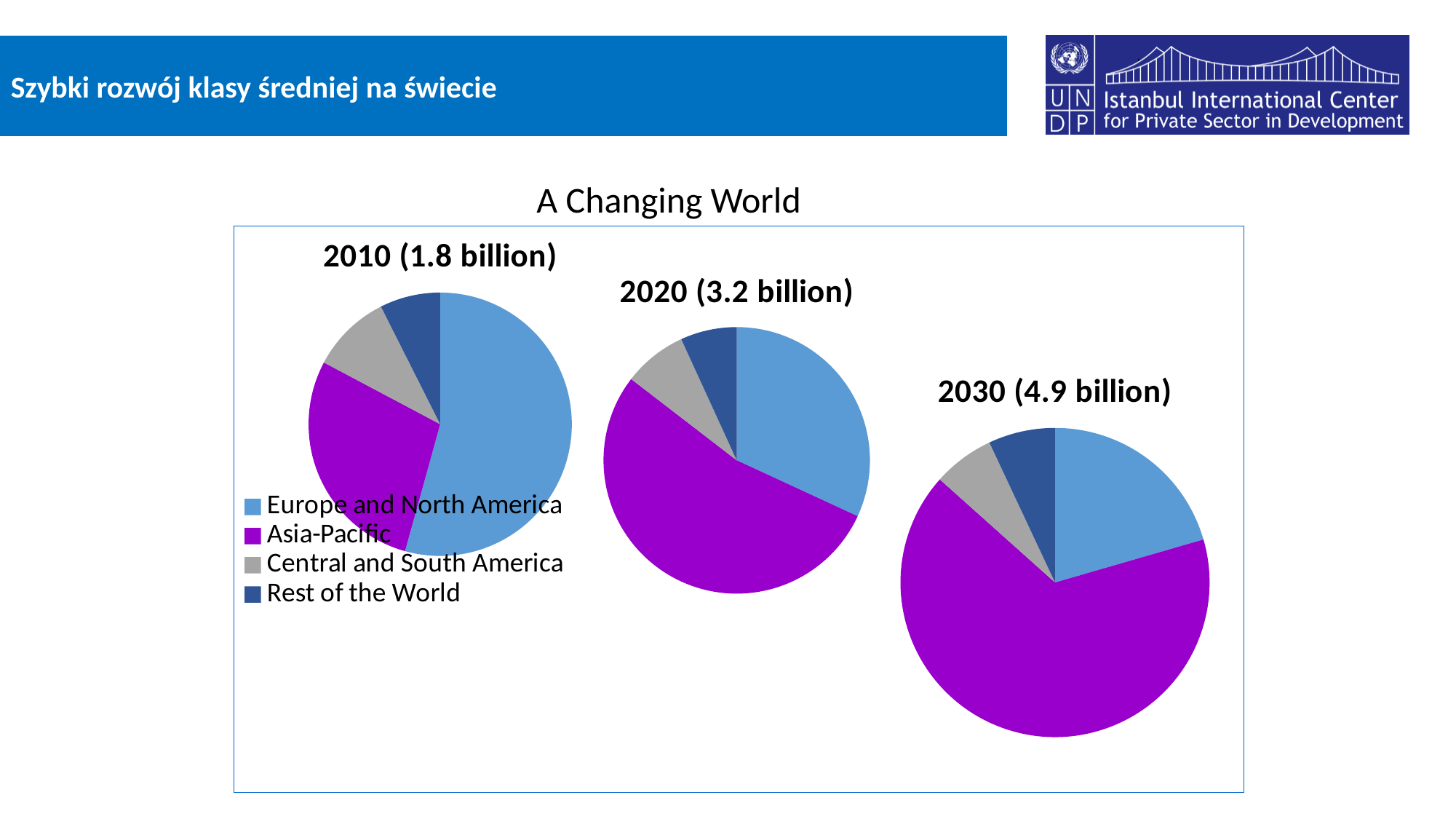
How many pie charts are shown on the slide? 3 What kind of charts are shown on the slide? Pie charts In the 2020 pie chart, which category has the largest slice? Asia-Pacific What is the total shown in the title of the 2020 pie chart? 3.2 billion What is the total shown in the title of the 2010 pie chart? 1.8 billion In the 2030 pie chart, which category has the largest slice? Asia-Pacific How many categories does the legend list? 4 In the 2010 pie chart, which category has the largest slice? Europe and North America What is the total shown in the title of the 2030 pie chart? 4.9 billion What is the overall title above the pie charts? A Changing World In the 2030 pie chart, which slice is larger: Asia-Pacific or Europe and North America? Asia-Pacific By how much does the total for 2030 exceed the total for 2010? 3.1 billion